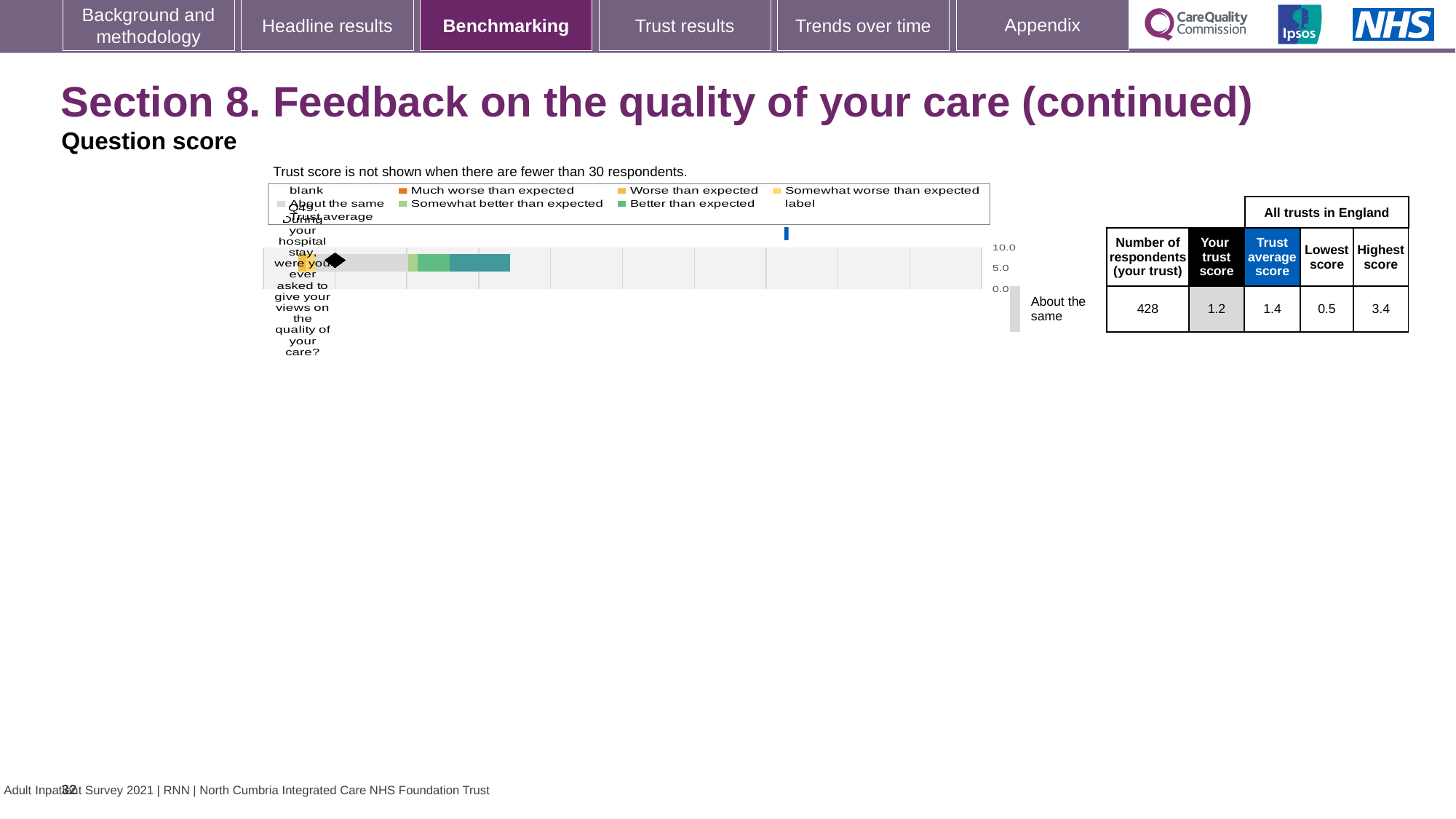
Is the trust's score for Q49 higher or lower than the trust average score? lower What is the trust score for Q49 shown in the table next to the chart? 1.2 What is the difference between the trust average score and the trust's own score for Q49? 0.2 How many respondents from the trust answered Q49? 428 What is the highest score among all trusts in England for Q49? 3.4 How many survey questions are plotted on the chart? 1 What kind of chart is used to show the Q49 benchmarking result? bar chart What is the difference between the highest and lowest scores for Q49 across all trusts in England? 2.9 What is the trust average score for Q49 across all trusts in England? 1.4 What benchmarking category is the trust's Q49 result labelled as next to the chart? About the same Which legend entry is shown with an orange colour? Much worse than expected What is the lowest score among all trusts in England for Q49? 0.5